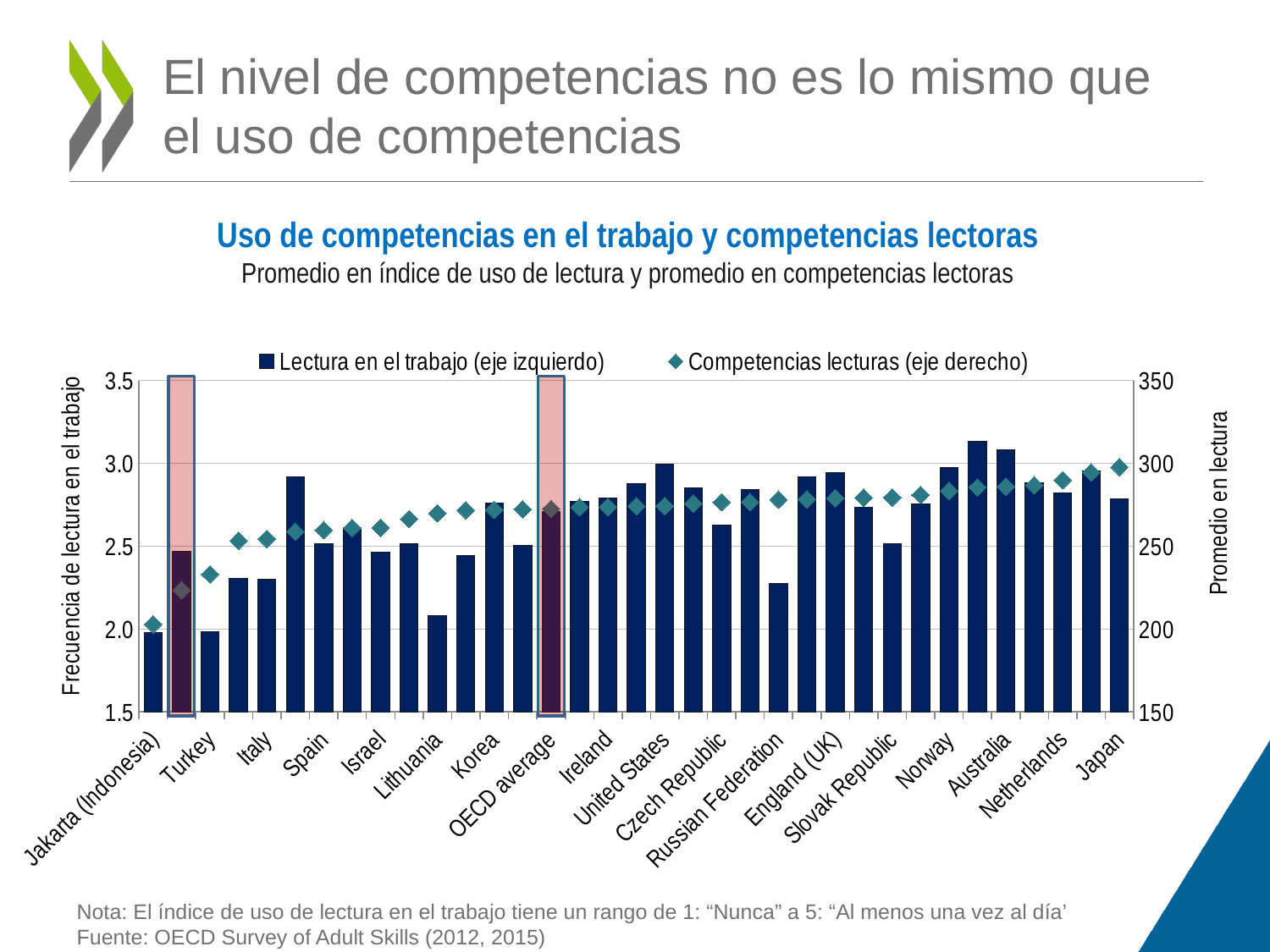
What is the title of the chart? Uso de competencias en el trabajo y competencias lectoras Is the Lectura en el trabajo value for Russian Federation greater or less than 2.5? less What kind of chart is shown on the slide? A combination chart of bars and diamond markers Is the Competencias lecturas value for Turkey greater or less than 250? less Is the Lectura en el trabajo value for Lithuania greater or less than 2.5? less Which has the larger Lectura en el trabajo value, Spain or Lithuania? Spain Do the Competencias lecturas values generally rise or fall from left to right along the x axis? rise Which has the larger Competencias lecturas value, Jakarta (Indonesia) or Japan? Japan Which category has the lowest value for Competencias lecturas (eje derecho)? Jakarta (Indonesia) How many series does the chart legend list? 2